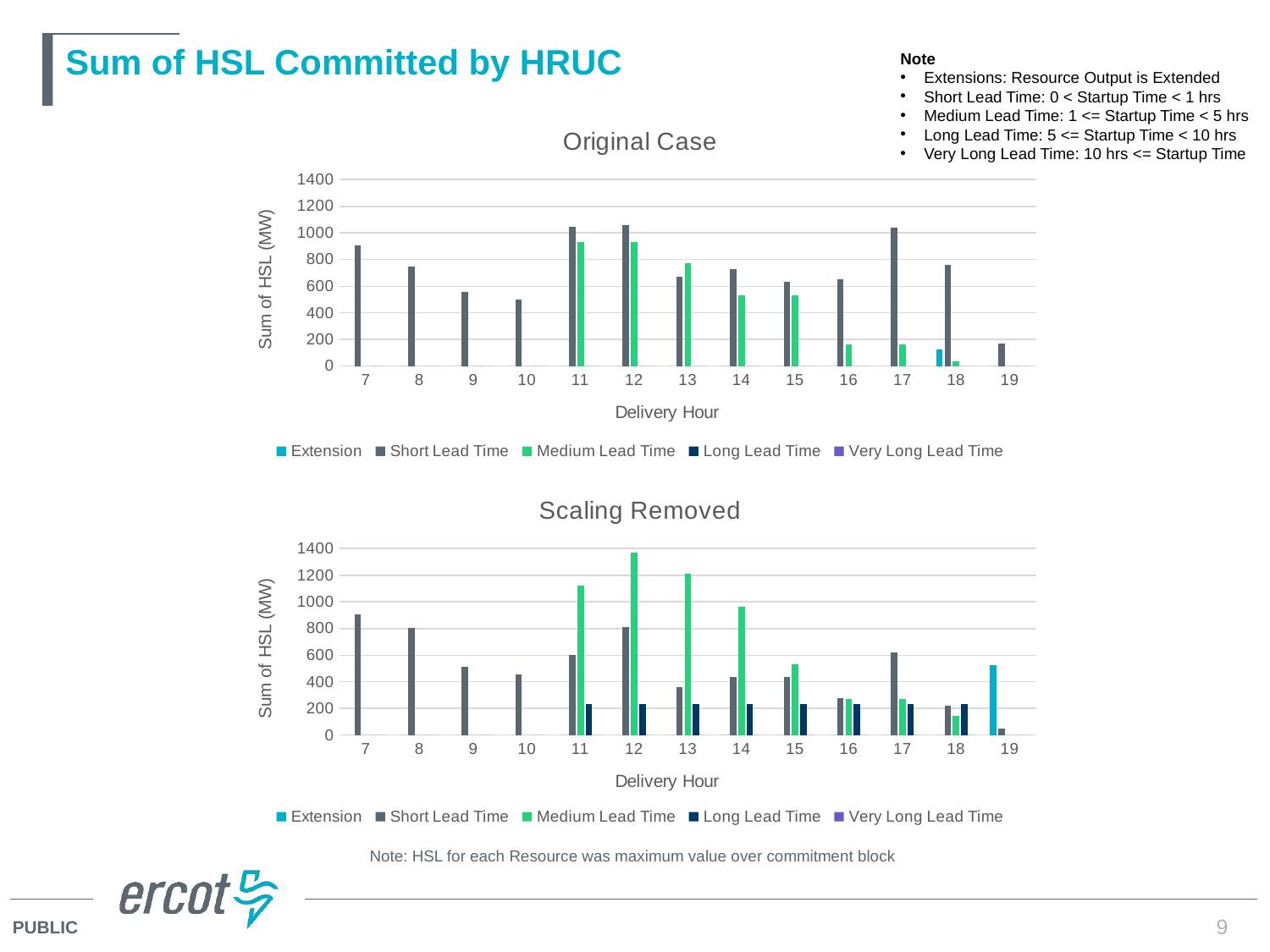
In the "Original Case" chart, at which delivery hour is the Short Lead Time value lowest? 19 What is the y-axis title of the "Scaling Removed" chart? Sum of HSL (MW) How many series does the legend of the "Original Case" chart list? 5 In the "Scaling Removed" chart, at which delivery hour is the Medium Lead Time value highest? 12 In the "Original Case" chart, is the Short Lead Time value at delivery hour 7 greater or less than 800? greater In the "Scaling Removed" chart, at delivery hour 13, which is larger: Short Lead Time or Medium Lead Time? Medium Lead Time How many delivery hours are shown on the x axis of the "Scaling Removed" chart? 13 In the "Original Case" chart, is the Medium Lead Time value at delivery hour 16 greater or less than 400? less In the "Scaling Removed" chart, is the Extension value at delivery hour 19 greater or less than 400? greater In the "Original Case" chart, at delivery hour 14, which is larger: Short Lead Time or Medium Lead Time? Short Lead Time What kind of chart is the "Original Case" chart? bar chart